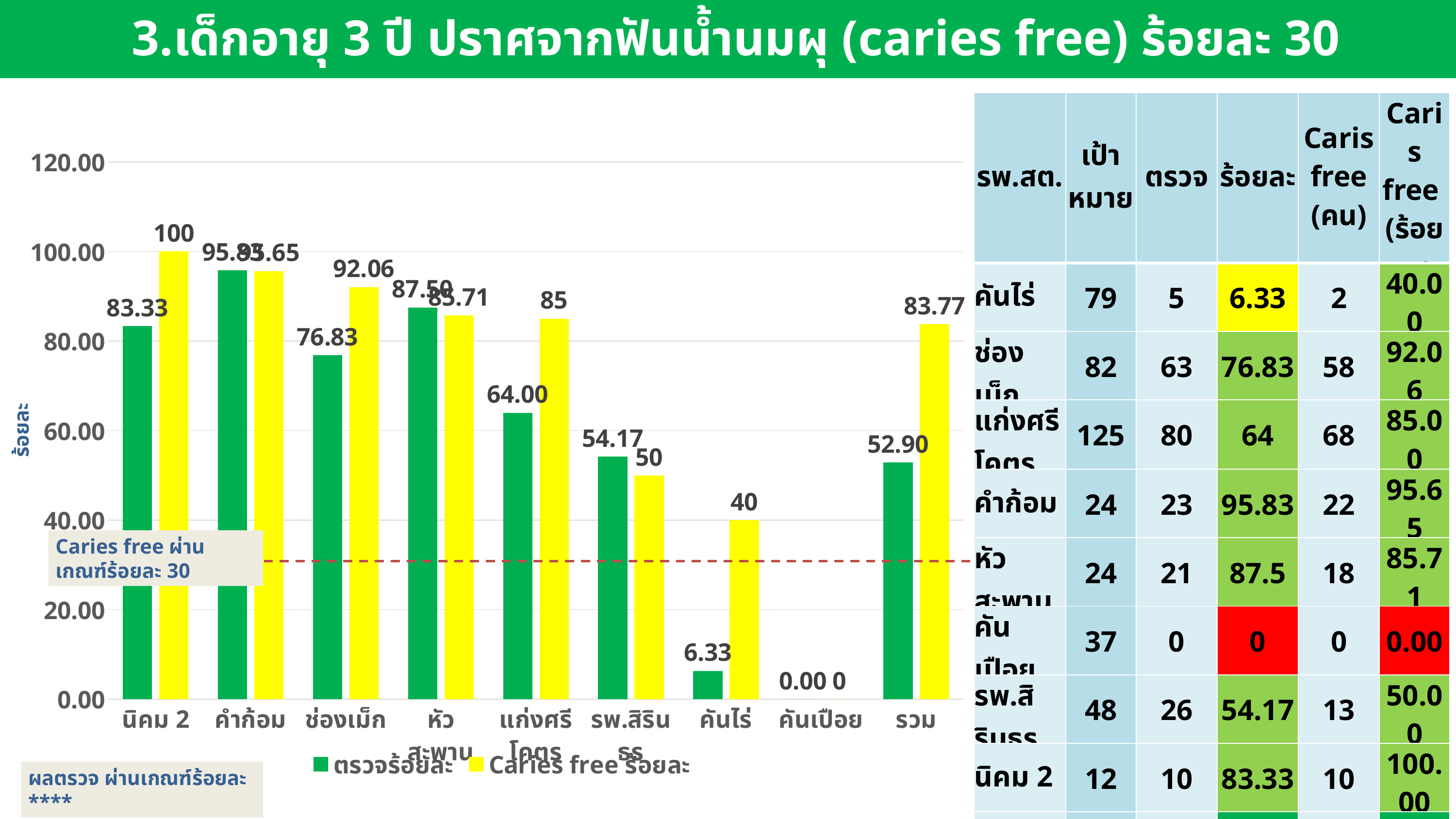
What is the Caries free ร้อยละ value for นิคม 2? 100 For ช่องเม็ก, what is the difference between the Caries free ร้อยละ value and the ตรวจร้อยละ value? 15.23 What is the ตรวจร้อยละ value for ช่องเม็ก? 76.83 For รพ.สิรินธร, which is larger: the ตรวจร้อยละ value or the Caries free ร้อยละ value? ตรวจร้อยละ Which category has the highest Caries free ร้อยละ value? นิคม 2 What is the Caries free ร้อยละ value for คันไร่? 40 What kind of chart is shown on the slide? bar chart How many categories are shown on the x axis of the chart? 9 How many series does the chart legend list? 2 Which category has the lowest ตรวจร้อยละ value? คันเปือย What is the Caries free ร้อยละ value for รวม? 83.77 What is the ตรวจร้อยละ value for รวม? 52.90